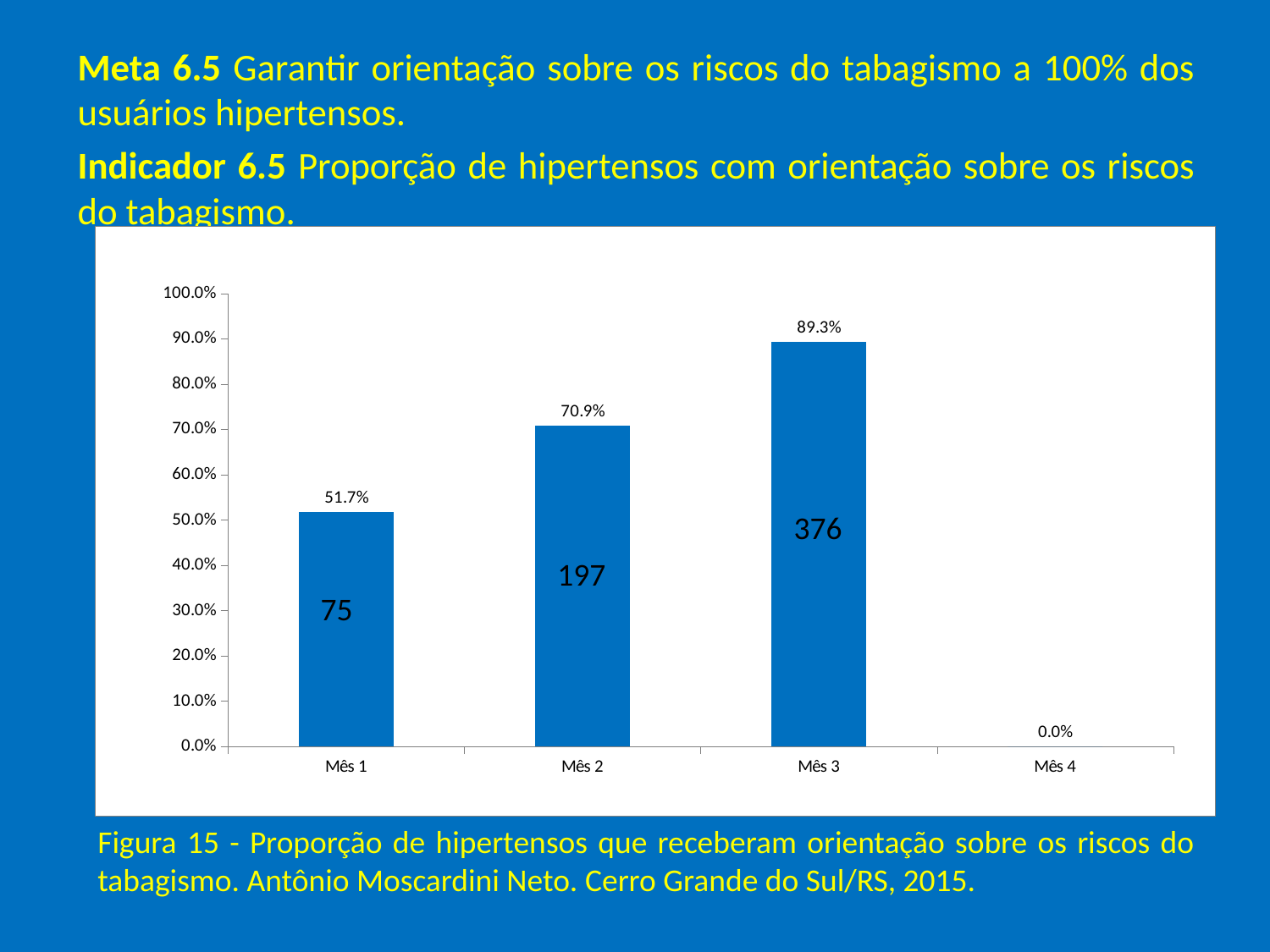
Which month has the highest percentage? Mês 3 Which month has the lowest percentage? Mês 4 What is the difference in percentage points between Mês 3 and Mês 1? 37.6 What number is printed inside the bar for Mês 3? 376 What is the percentage value shown for Mês 1? 51.7% What number is printed inside the bar for Mês 2? 197 How many months (categories) are shown on the x axis? 4 Which is larger, the percentage for Mês 1 or for Mês 2? Mês 2 What is the percentage value shown for Mês 2? 70.9% Do the percentages rise or fall from Mês 1 to Mês 3? Rise What kind of chart is shown on the slide? Bar chart What is the percentage value shown for Mês 3? 89.3%